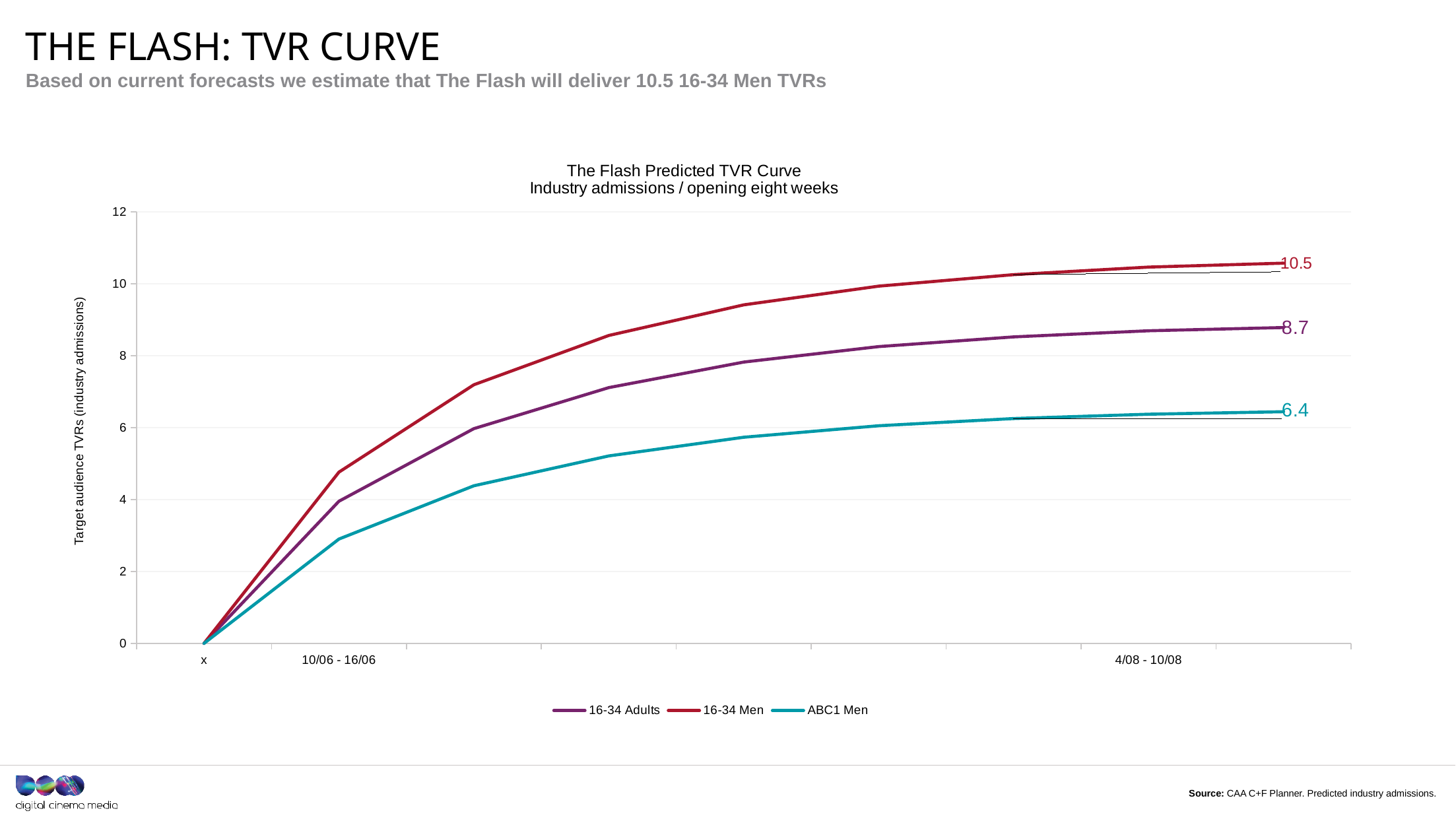
What is the final labelled value for the 16-34 Men series? 10.5 How many series does the legend list? 3 Which series reaches the highest final value? 16-34 Men What is the title of the chart? The Flash Predicted TVR Curve Industry admissions / opening eight weeks What is the difference between the final values of 16-34 Men and 16-34 Adults? 1.8 What is the difference between the final values of 16-34 Men and ABC1 Men? 4.1 Which has a larger final value, 16-34 Adults or ABC1 Men? 16-34 Adults Which series has the lowest final value? ABC1 Men What is the final labelled value for the 16-34 Adults series? 8.7 What type of chart is shown on the slide? Line chart What is the final labelled value for the ABC1 Men series? 6.4 Do the values of the 16-34 Men series rise or fall along the x axis? Rise